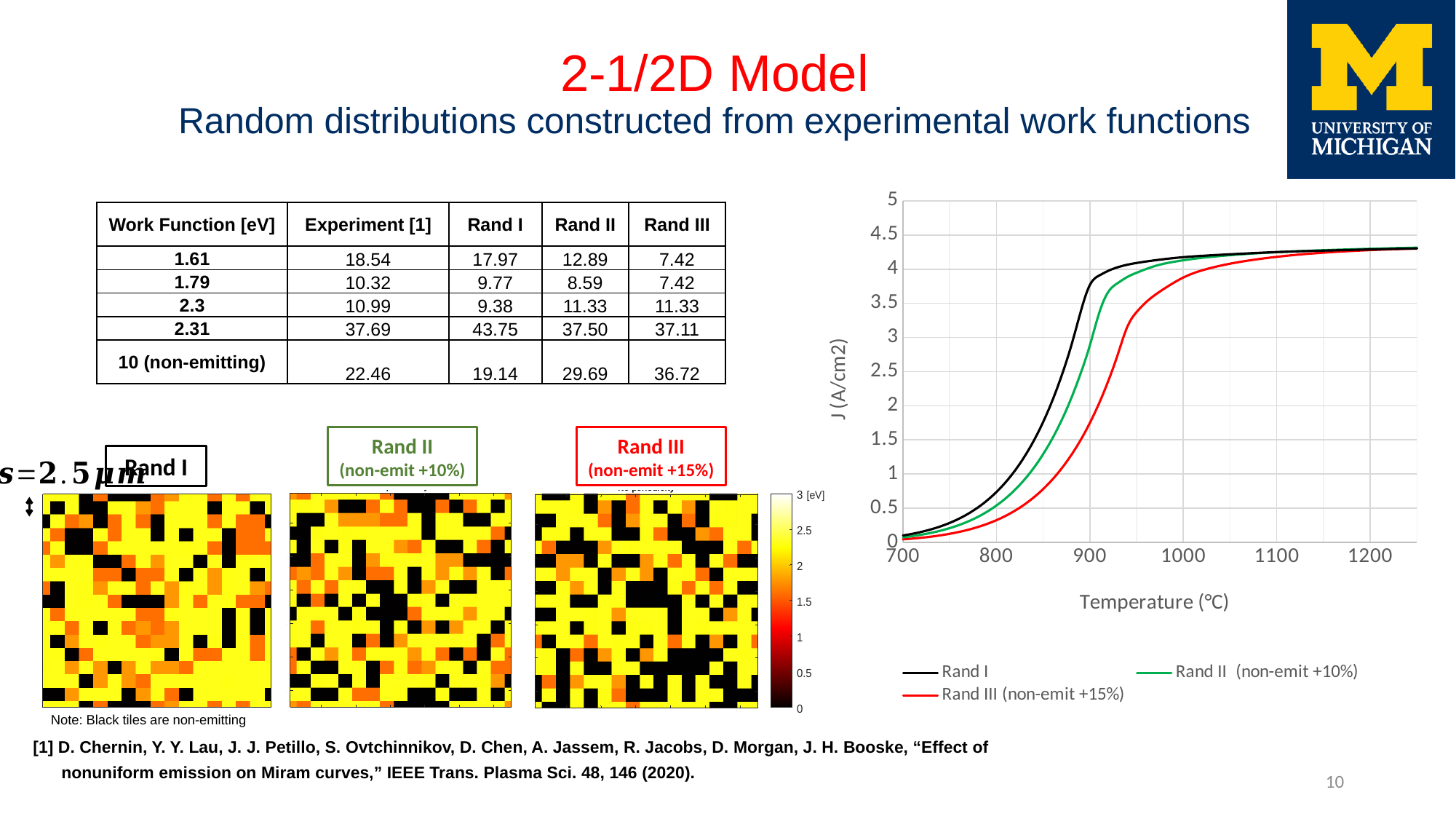
In the J versus Temperature chart, is the value for Rand III (non-emit +15%) at 900 °C greater or less than 2.5? less In the J versus Temperature chart, at 900 °C, which is larger: the value for Rand I or the value for Rand III (non-emit +15%)? Rand I In the J versus Temperature chart, is the value for Rand I at 800 °C greater or less than 1? less In the J versus Temperature chart, which series has the highest current density at 900 °C? Rand I In the J versus Temperature chart, is the value for Rand I at 900 °C greater or less than 3? greater In the J versus Temperature chart, do the curves rise or fall as temperature increases from 700 to 1200 °C? rise What kind of chart is the plot of J versus Temperature on the right of the slide? line chart What is the y-axis label of the J versus Temperature chart? J (A/cm2) In the J versus Temperature chart, which series has the lowest current density at 900 °C? Rand III (non-emit +15%) How many series does the legend of the J versus Temperature chart list? 3 In the J versus Temperature chart, what colour is the line for Rand III (non-emit +15%)? red